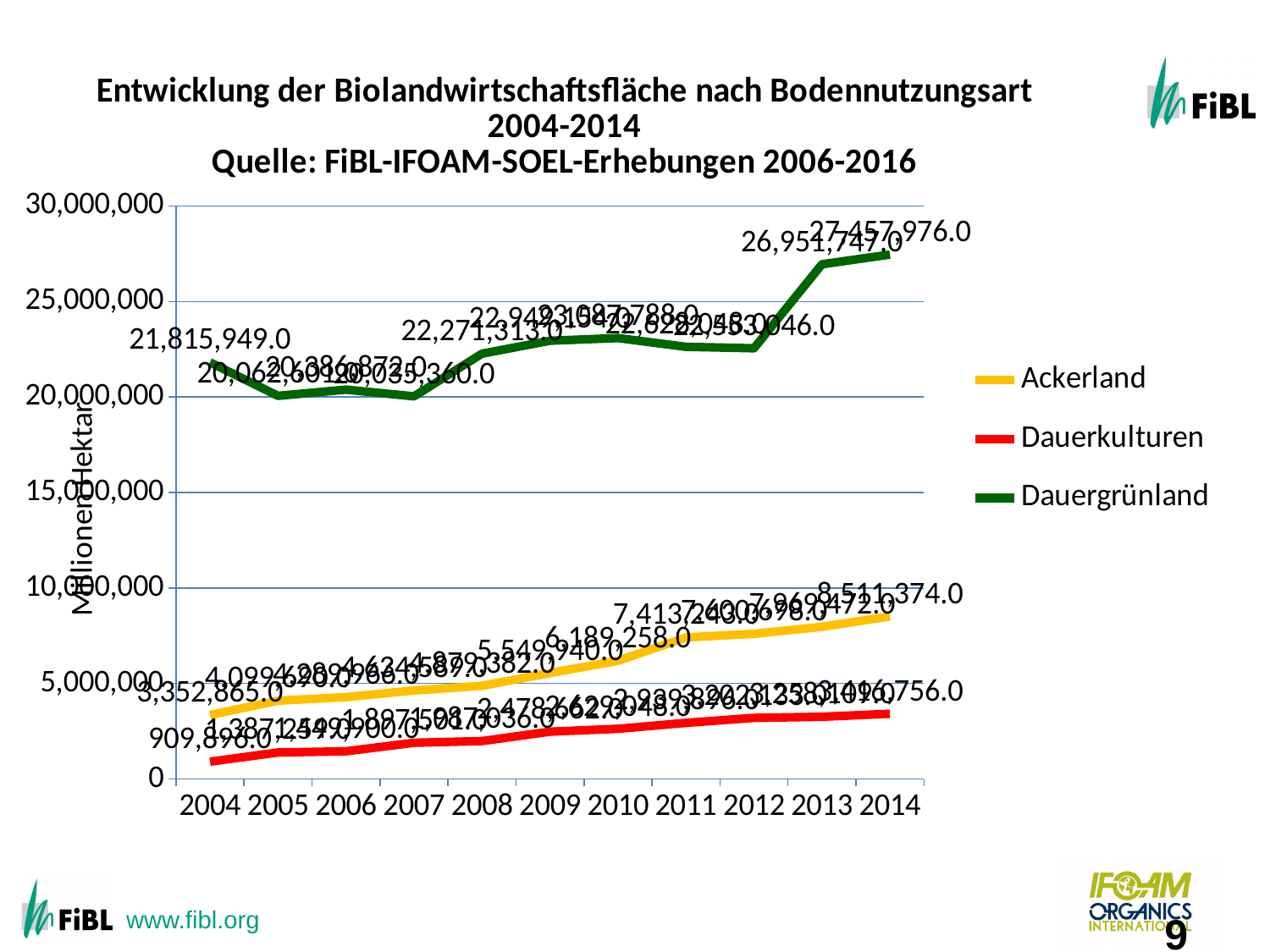
How many years are shown on the x axis? 11 What is the value for Dauergrünland in 2014? 27,457,976.0 What type of chart is shown on the slide? line chart What is the value for Ackerland in 2014? 8,511,374.0 Which series has the highest values throughout the chart? Dauergrünland By how much did Dauergrünland increase from 2004 to 2014? 5,642,027.0 What is the value for Dauergrünland in 2004? 21,815,949.0 How many series does the legend list? 3 What is the value for Ackerland in 2004? 3,352,865.0 What is the value for Dauerkulturen in 2004? 909,896.0 Is the value for Dauerkulturen in 2014 greater or less than 5,000,000? less Does the Ackerland series rise or fall from 2004 to 2014? rise